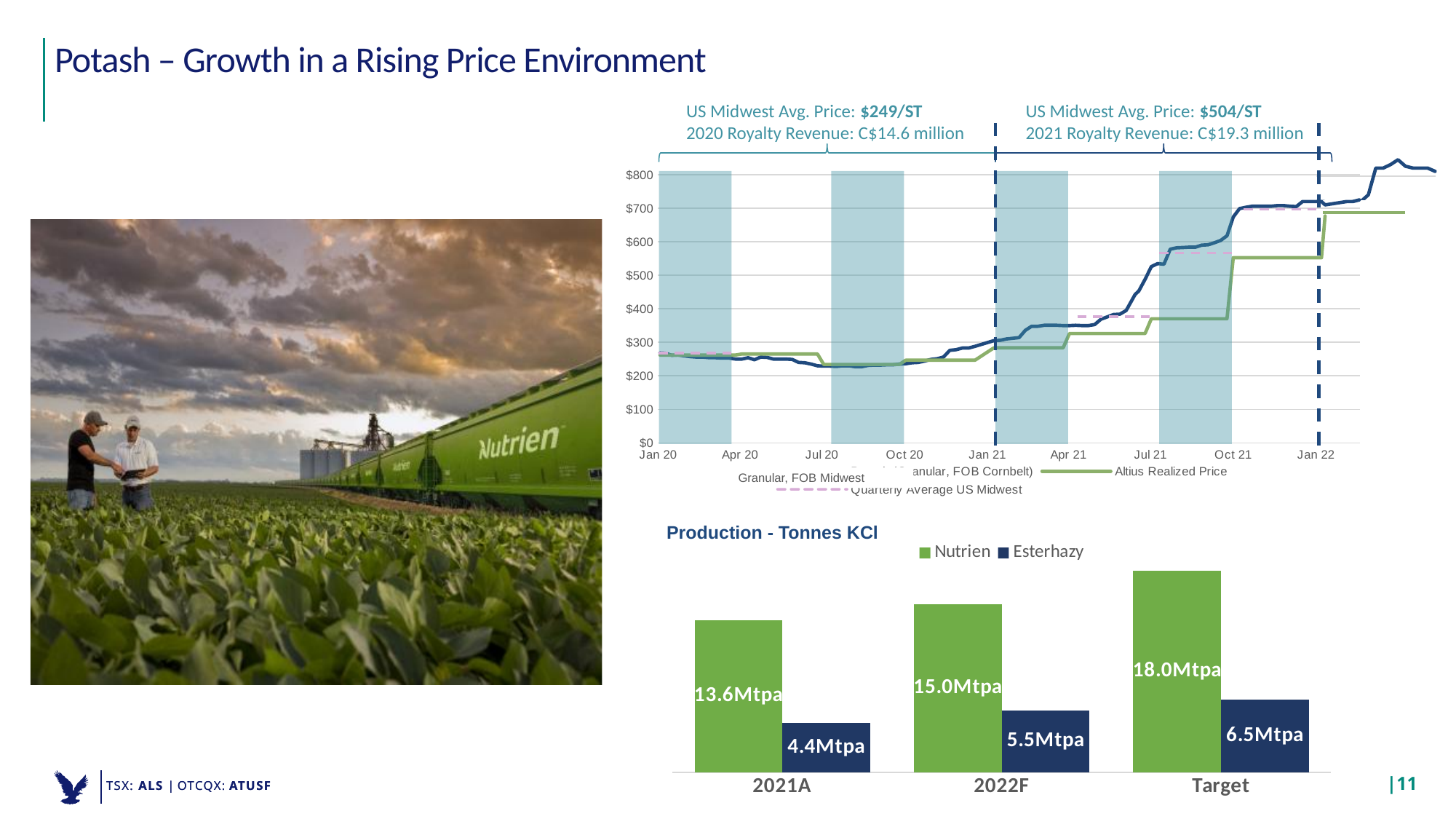
In the Production - Tonnes KCl chart, what is the Nutrien value for 2021A? 13.6Mtpa In the Production - Tonnes KCl chart, what is the Nutrien value for 2022F? 15.0Mtpa In the Production - Tonnes KCl chart, which is larger: Nutrien 2022F or Esterhazy Target? Nutrien 2022F In the Production - Tonnes KCl chart, what is the Esterhazy value for Target? 6.5Mtpa In the Production - Tonnes KCl chart, how much higher is the Nutrien Target value than the Nutrien 2021A value? 4.4Mtpa In the Production - Tonnes KCl chart, what is the Esterhazy value for 2021A? 4.4Mtpa In the Production - Tonnes KCl chart, how many series does the legend list? 2 In the Production - Tonnes KCl chart, do the Esterhazy values rise or fall from 2021A to Target? rise In the Production - Tonnes KCl chart, what is the difference between the Esterhazy 2022F and 2021A values? 1.1Mtpa What kind of chart is the Production - Tonnes KCl chart? bar chart In the Production - Tonnes KCl chart, how many categories are shown on the x axis? 3